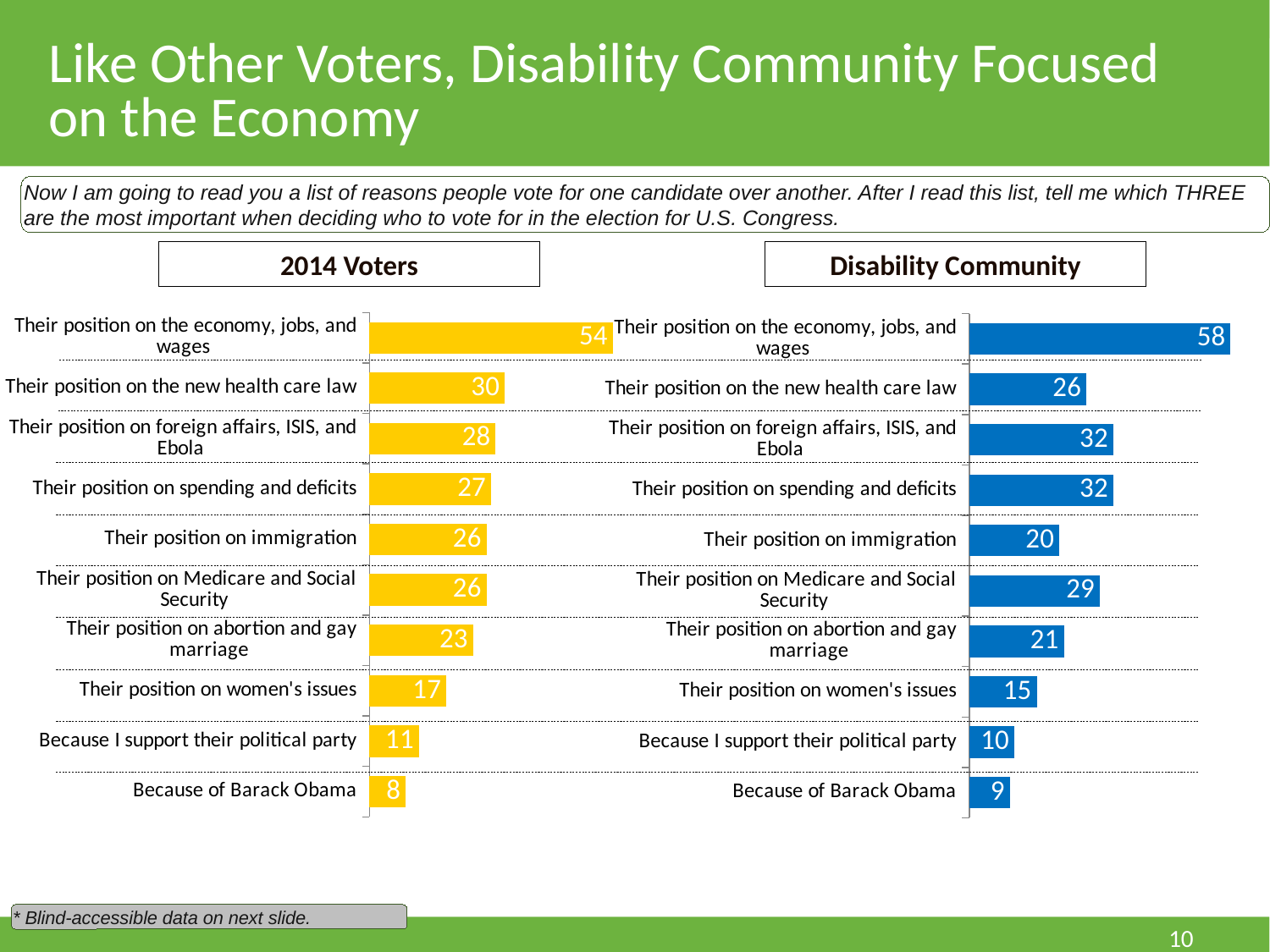
In the Disability Community chart, what is the value for "Their position on Medicare and Social Security"? 29 In the Disability Community chart, what is the value for "Their position on the economy, jobs, and wages"? 58 In the 2014 Voters chart, which category has the lowest value? Because of Barack Obama In the 2014 Voters chart, what is the value for "Because I support their political party"? 11 What colour are the bars in the 2014 Voters chart? Yellow In the 2014 Voters chart, what is the value for "Their position on the economy, jobs, and wages"? 54 In the Disability Community chart, what is the difference between "Their position on foreign affairs, ISIS, and Ebola" and "Their position on immigration"? 12 In the 2014 Voters chart, what is the difference between "Their position on the new health care law" and "Their position on women's issues"? 13 In the Disability Community chart, which category has the highest value? Their position on the economy, jobs, and wages Which is larger: the value for "Their position on the new health care law" in the 2014 Voters chart or in the Disability Community chart? 2014 Voters What type of chart is the Disability Community chart? Bar chart How many categories does the 2014 Voters chart show? 10